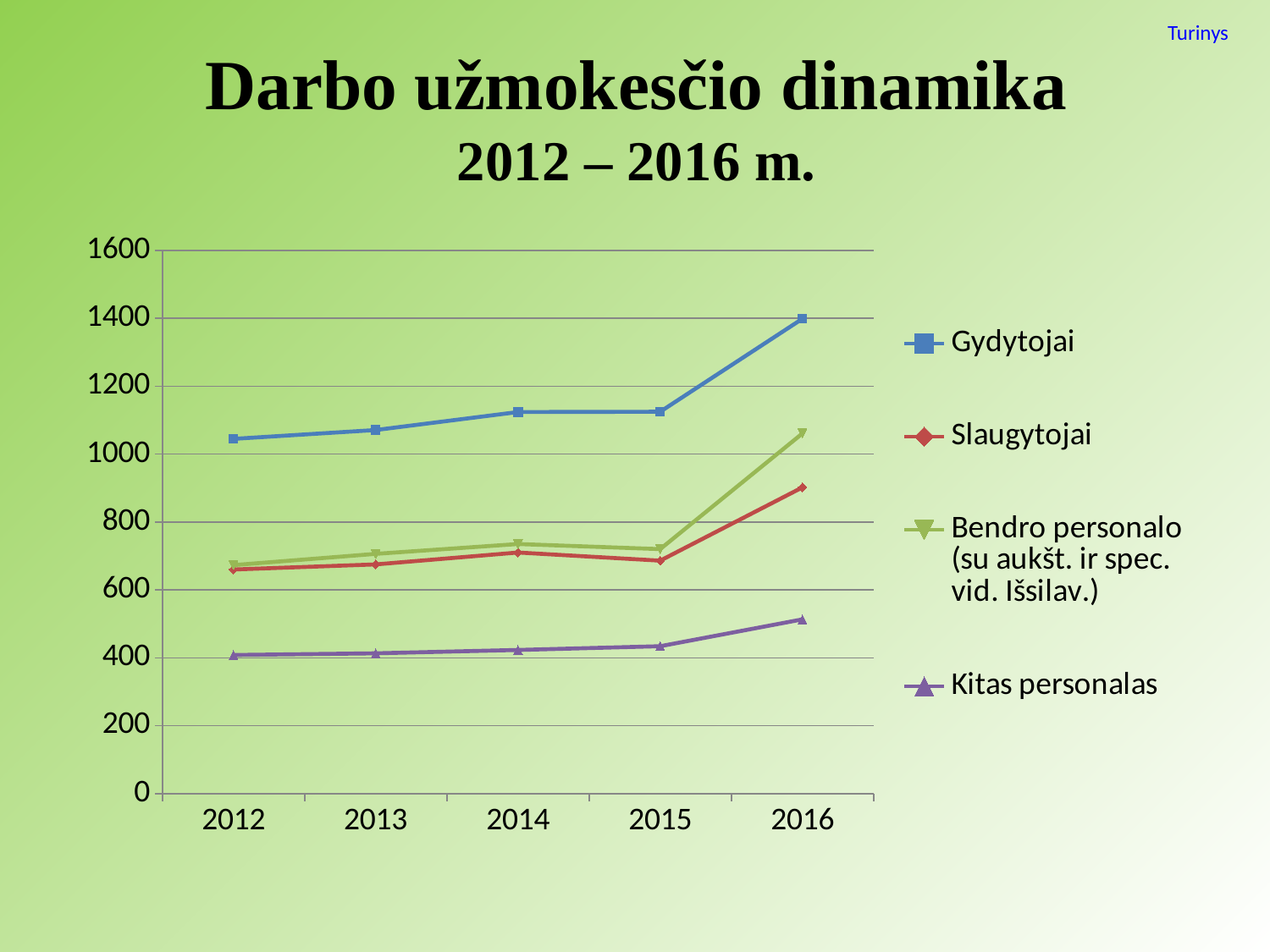
How many years are shown on the x axis? 5 Which series has the highest value in 2016? Gydytojai Is the value for Slaugytojai in 2016 greater or less than 800? greater Is the value for Gydytojai in 2016 greater or less than 1200? greater What is the title of the slide? Darbo užmokesčio dinamika 2012 – 2016 m. In 2016, which is higher: Bendro personalo (su aukšt. ir spec. vid. Išsilav.) or Slaugytojai? Bendro personalo (su aukšt. ir spec. vid. Išsilav.) Does the Gydytojai line rise or fall from 2012 to 2016? rise How many series does the legend list? 4 Is the value for Kitas personalas in 2012 greater or less than 600? less What type of chart is shown on the slide? line chart Which series has the lowest value in 2016? Kitas personalas